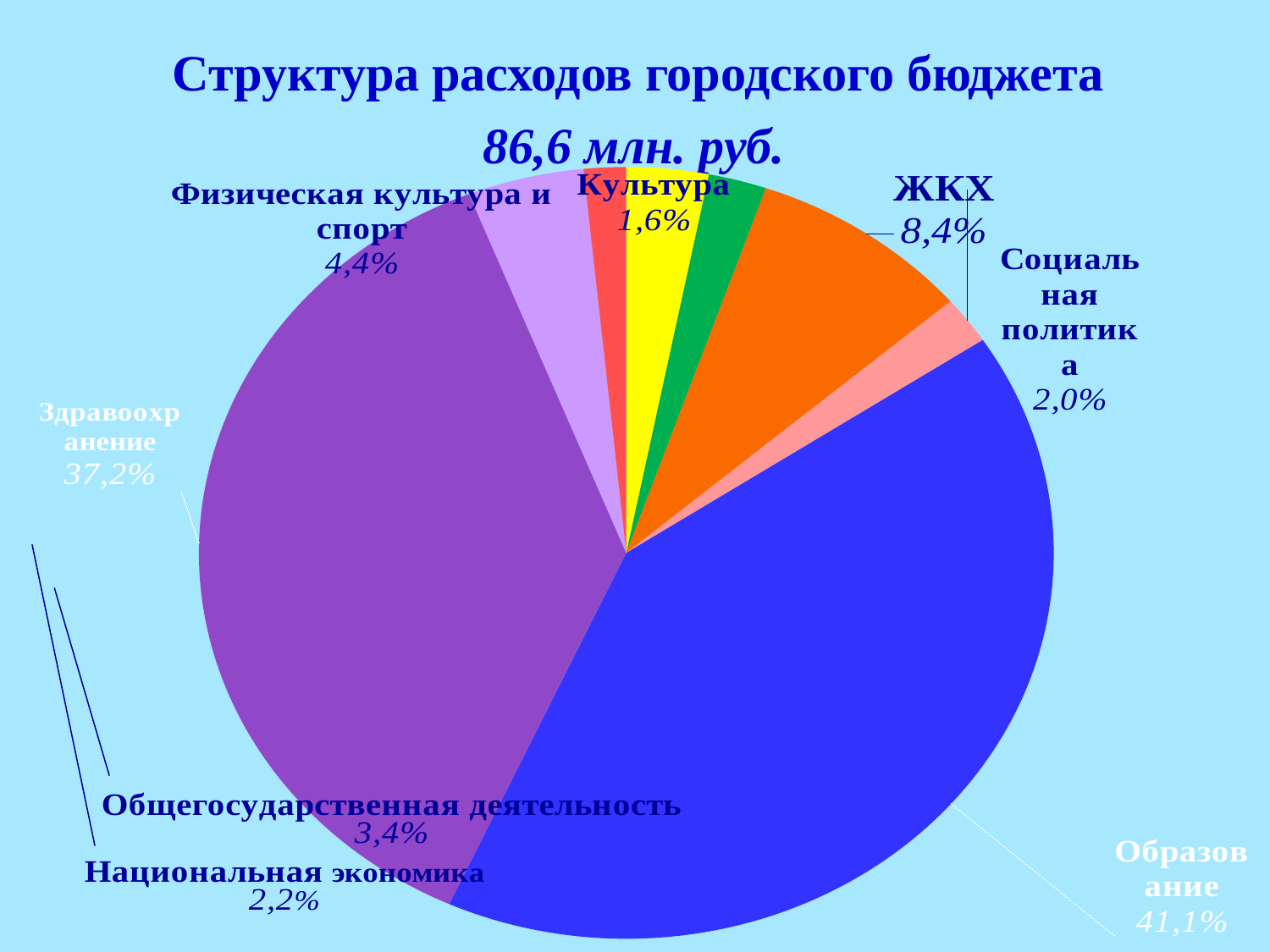
Which is larger, the share for Физическая культура и спорт or the share for Общегосударственная деятельность? Физическая культура и спорт What percentage is shown for Социальная политика? 2,0% What share of the city budget expenditure goes to Здравоохранение? 37,2% How many slices does the pie chart have? 8 What percentage is shown for ЖКХ? 8,4% Which category has the smallest share of the budget expenditure? Культура Which category has the largest share of the budget expenditure? Образование What kind of chart is shown on the slide? pie chart What total budget amount is stated in the chart title? 86,6 млн. руб. What share of the city budget expenditure goes to Образование? 41,1% What is the difference in percentage points between Образование and Здравоохранение? 3,9 What percentage is shown for Культура? 1,6%